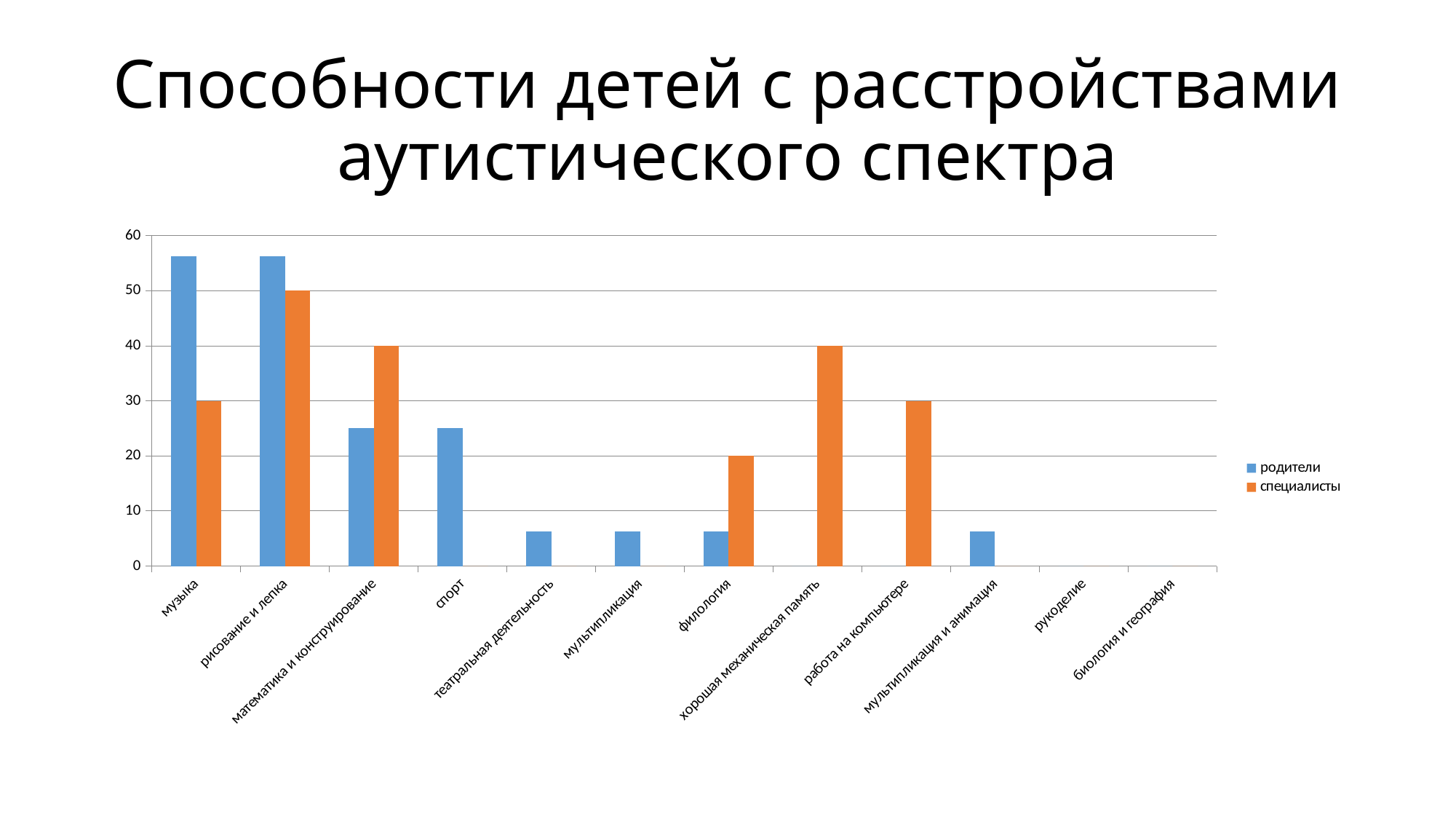
What is the value for специалисты in the category музыка? 30 Is the value for родители in the category спорт greater or less than 30? less What is the value for специалисты in the category филология? 20 What kind of chart is shown on the slide? bar chart How many series does the legend list? 2 Which category has the highest value for специалисты? рисование и лепка In the category музыка, which series has the larger value, родители or специалисты? родители How many categories are shown on the x axis? 12 Is the value for родители in the category музыка greater or less than 50? greater What is the value for специалисты in the category хорошая механическая память? 40 What is the value for специалисты in the category рисование и лепка? 50 What is the difference between the специалисты values for рисование и лепка and музыка? 20